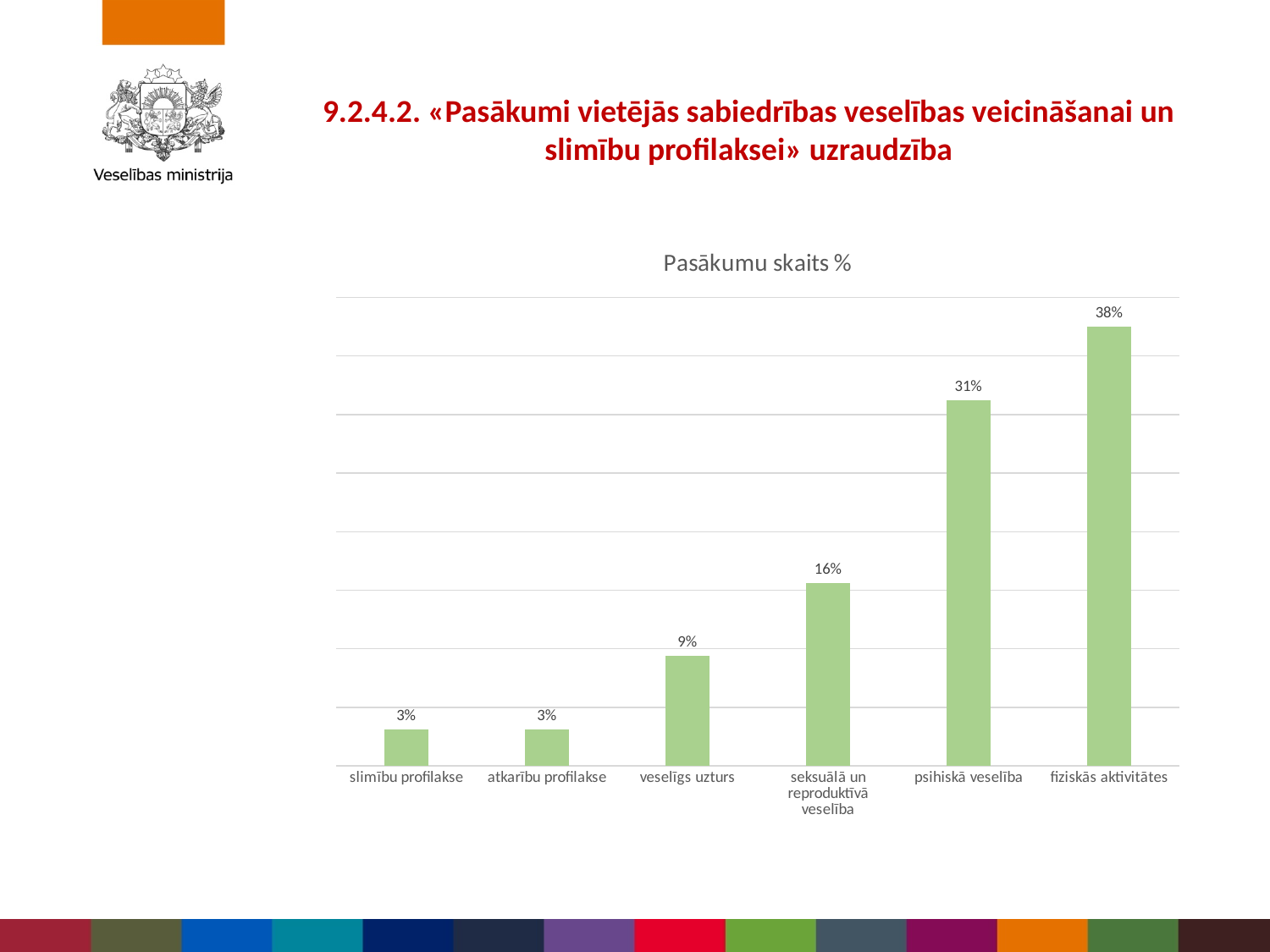
How many categories are shown on the chart? 6 Which is larger, psihiskā veselība or seksuālā un reproduktīvā veselība? psihiskā veselība What is the value for psihiskā veselība? 31% What is the difference between fiziskās aktivitātes and psihiskā veselība? 7% What is the value for veselīgs uzturs? 9% Do the values rise or fall from left to right along the x axis? rise What is the value for fiziskās aktivitātes? 38% What is the difference between seksuālā un reproduktīvā veselība and veselīgs uzturs? 7% Which category has the highest value? fiziskās aktivitātes What kind of chart is shown? bar chart What is the title of the chart? Pasākumu skaits % What is the value for seksuālā un reproduktīvā veselība? 16%